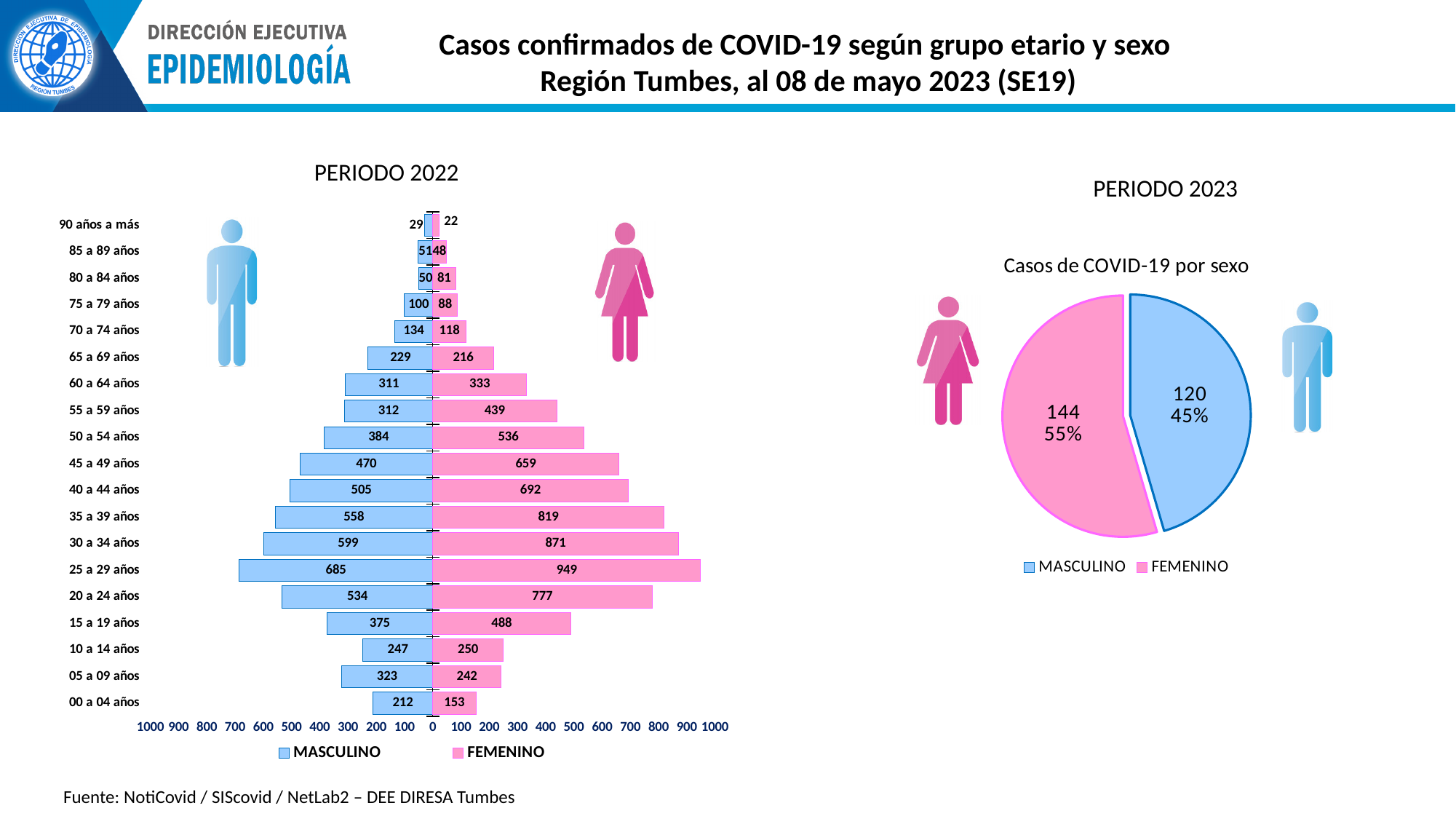
In the PERIODO 2023 pie chart, what is the value for FEMENINO? 144 How many series does the legend of the PERIODO 2022 chart list? 2 In the PERIODO 2022 chart, which is larger for the 05 a 09 años group, MASCULINO or FEMENINO? MASCULINO In the PERIODO 2022 chart, which age group has the highest MASCULINO value? 25 a 29 años In the PERIODO 2022 chart, which age group has the lowest FEMENINO value? 90 años a más What is the title of the PERIODO 2023 pie chart? Casos de COVID-19 por sexo How many age groups are shown in the PERIODO 2022 chart? 19 In the PERIODO 2022 chart, what is the FEMENINO value for the 25 a 29 años group? 949 In the PERIODO 2022 chart, what is the difference between the FEMENINO and MASCULINO values for the 30 a 34 años group? 272 What kind of chart is the PERIODO 2022 chart? Bar chart In the PERIODO 2022 chart, what is the MASCULINO value for the 45 a 49 años group? 470 In the PERIODO 2023 pie chart, what share of cases is MASCULINO? 45%